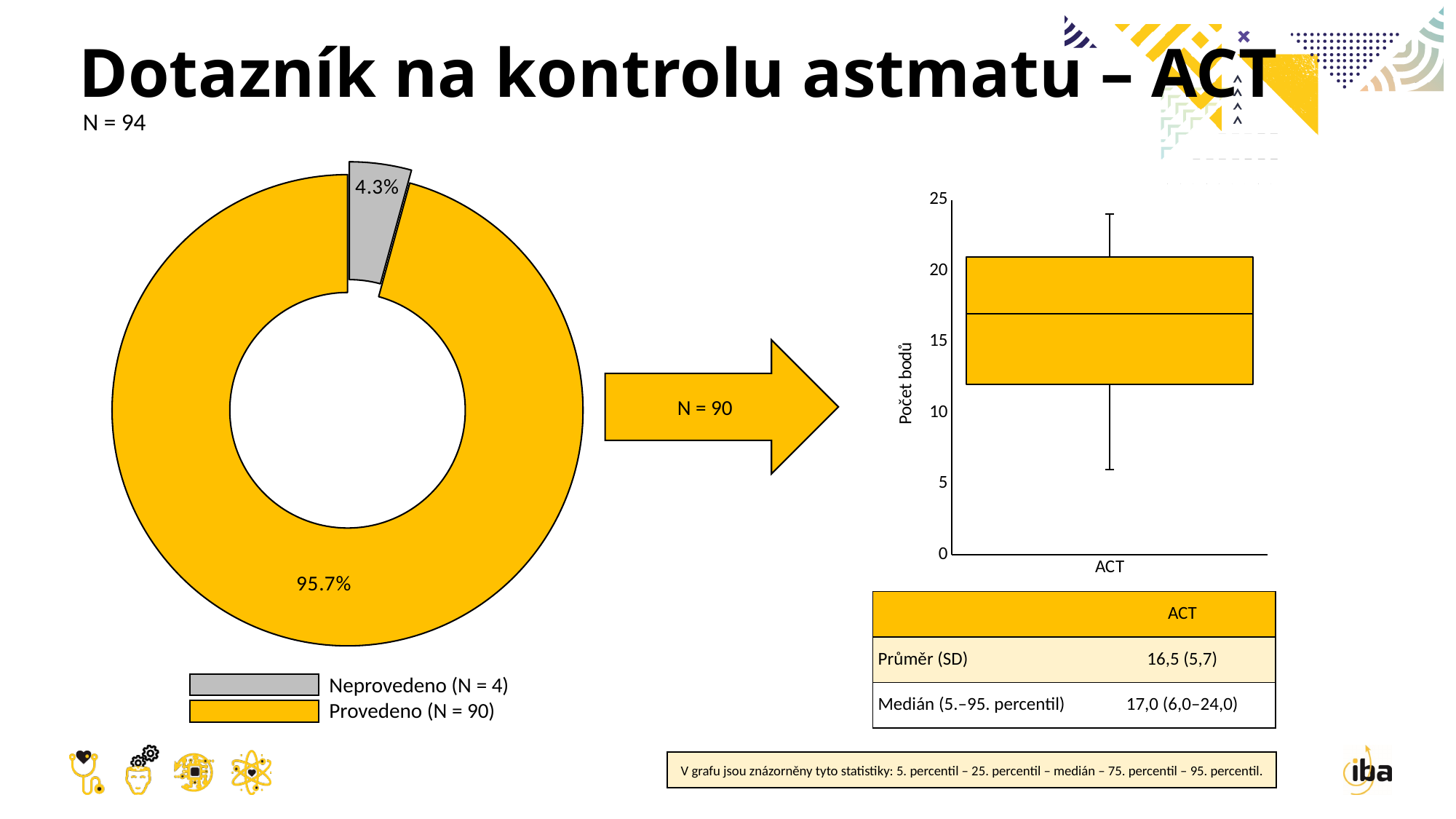
In the pie chart on the left, what percentage is shown for the Neprovedeno slice? 4.3% In the box plot on the right, is the lower whisker end for ACT greater or less than 10? less In the pie chart on the left, how many patients does the legend give for Neprovedeno? N = 4 In the pie chart on the left, what colour is the Provedeno slice? yellow In the pie chart on the left, what percentage is shown for the Provedeno slice? 95.7% In the pie chart on the left, how many slices are there? 2 In the pie chart on the left, what is the difference in percentage points between the Provedeno and Neprovedeno slices? 91.4 In the pie chart on the left, which slice is the largest? Provedeno What kind of chart is the chart on the left side of the slide? pie chart (donut) In the pie chart on the left, which slice is the smallest? Neprovedeno What kind of chart is the chart on the right side of the slide? box plot In the box plot on the right, is the median line for ACT greater or less than 15? greater